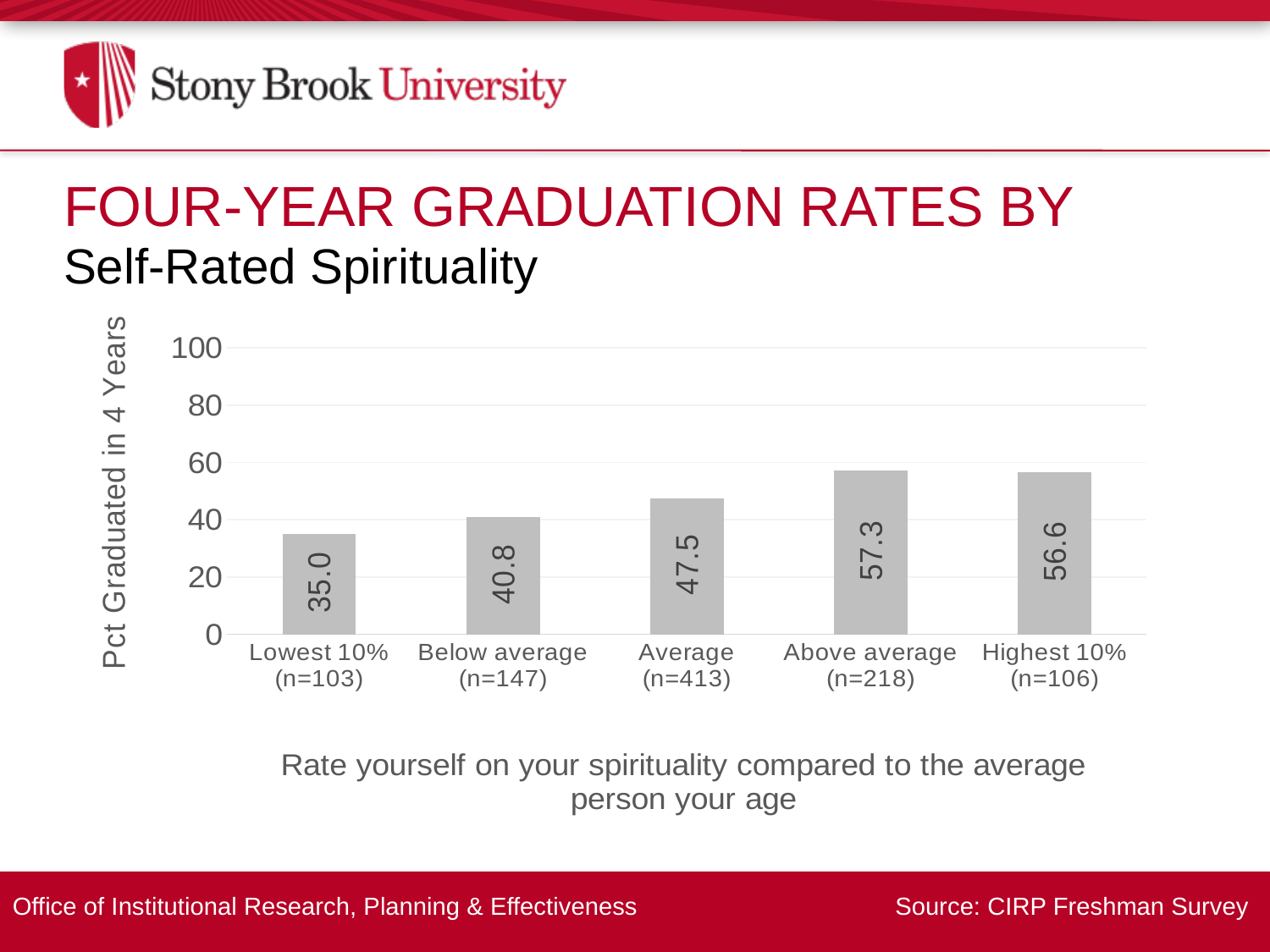
How many spirituality categories are shown on the chart? 5 What is the four-year graduation rate for students who rated their spirituality as Average? 47.5 Which group has a higher four-year graduation rate, Below average or Average? Average Is the four-year graduation rate for the Above average group greater or less than 60? less What is the difference in four-year graduation rate between the Above average and Lowest 10% groups? 22.3 Which spirituality group has the lowest four-year graduation rate? Lowest 10% Which spirituality group has the highest four-year graduation rate? Above average What is the four-year graduation rate for the Lowest 10% spirituality group? 35.0 What is the four-year graduation rate for the Highest 10% spirituality group? 56.6 What kind of chart is shown on the slide? Bar chart What is the sample size (n) for the Average spirituality group? 413 What is the difference in four-year graduation rate between the Average and Below average groups? 6.7